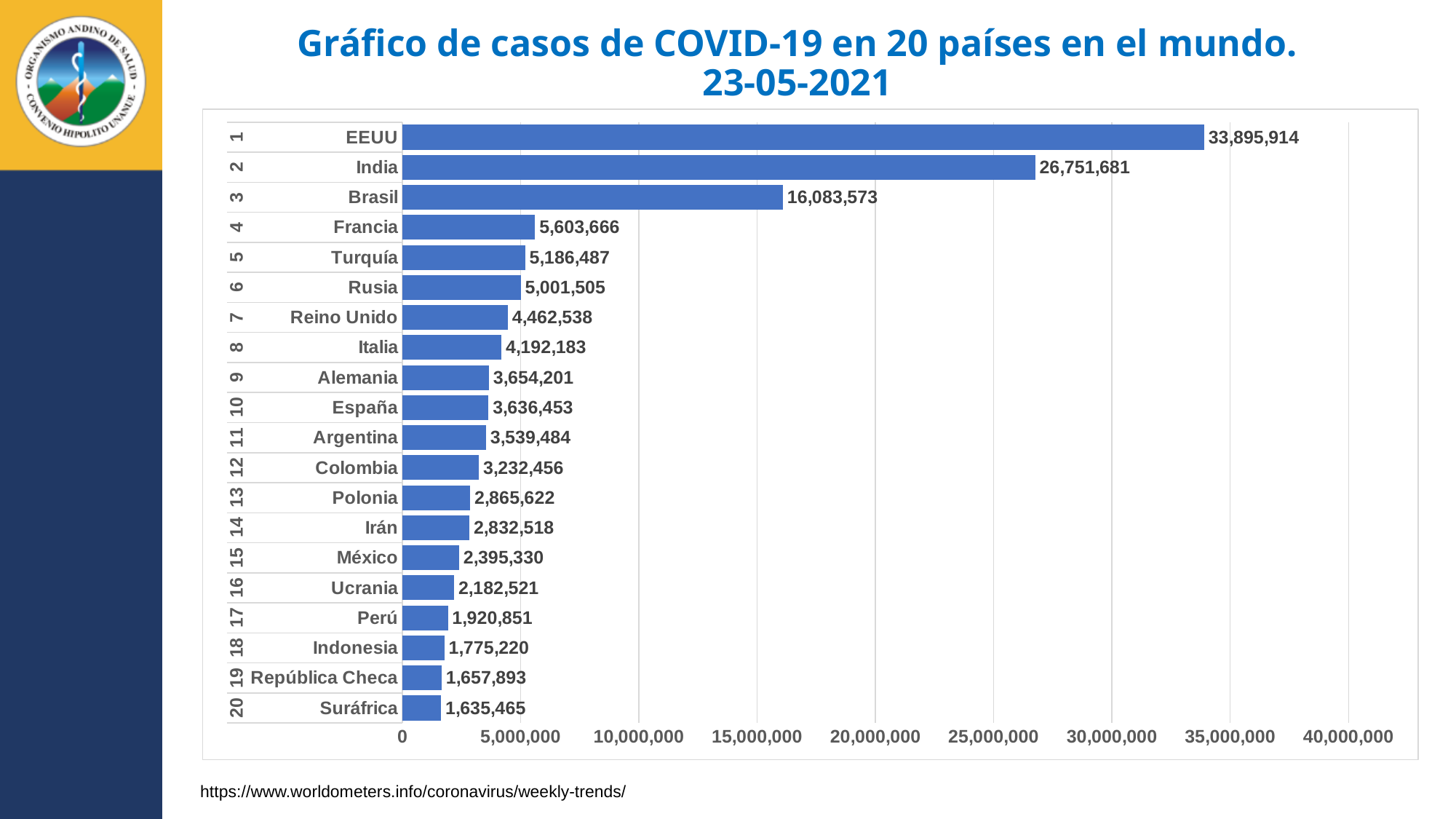
What date is given in the chart title? 23-05-2021 Which country has the highest number of COVID-19 cases in the chart? EEUU Is the value for Brasil greater or less than 15,000,000? greater How many countries are shown in the chart? 20 How many COVID-19 cases are shown for Colombia? 3,232,456 What kind of chart is shown on the slide? bar chart Which has more cases, Turquía or Rusia? Turquía Which country has the lowest number of COVID-19 cases in the chart? Suráfrica What is the difference in cases between Brasil and Francia? 10,479,907 What is the difference in cases between EEUU and India? 7,144,233 How many COVID-19 cases are shown for India? 26,751,681 How many COVID-19 cases are shown for Perú? 1,920,851